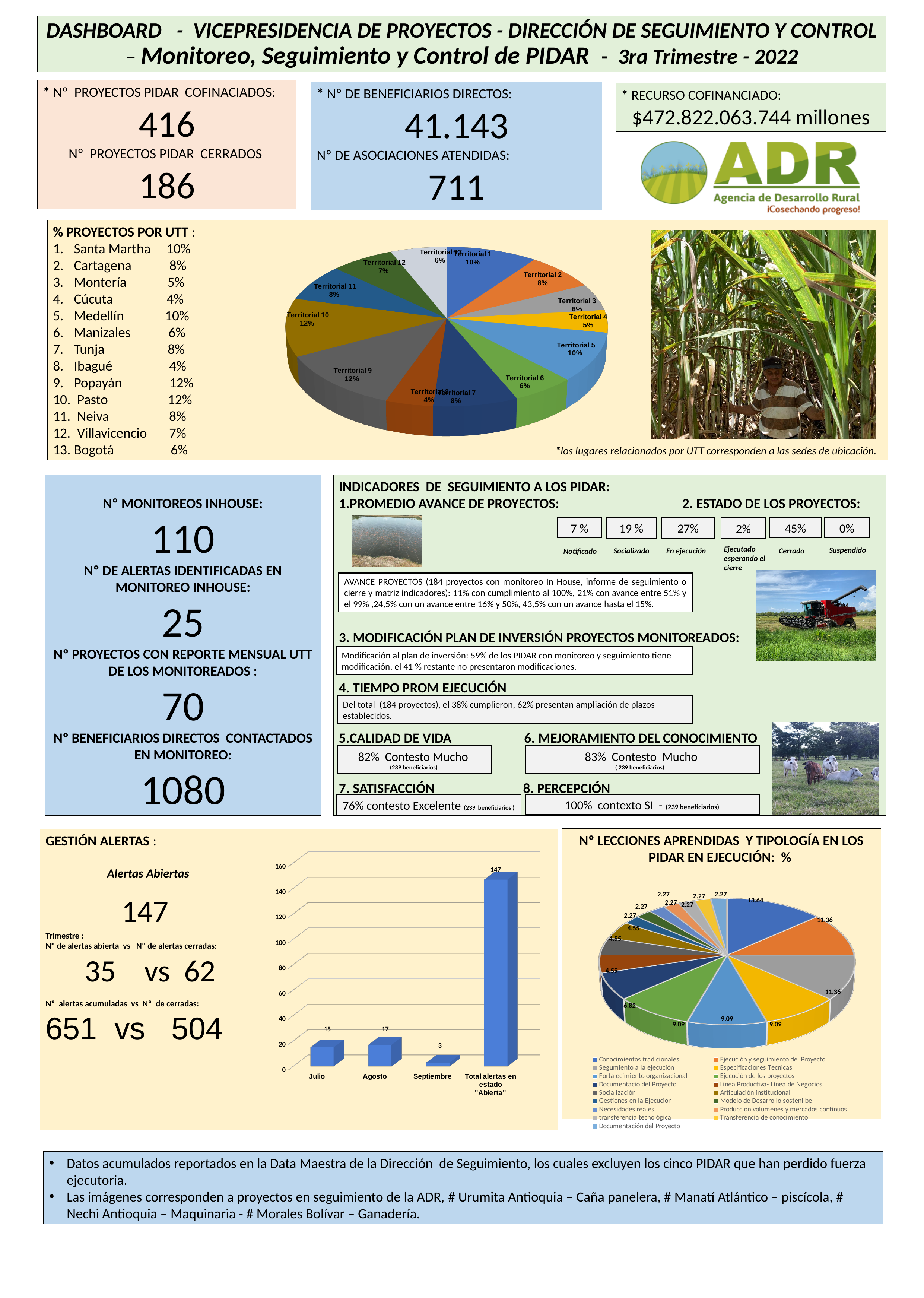
In the bar chart under GESTIÓN ALERTAS, what is the value for Agosto? 17 In the bar chart under GESTIÓN ALERTAS, which category has the highest value? Total alertas en estado "Abierta" In the bar chart under GESTIÓN ALERTAS, how many categories are shown on the x axis? 4 In the bar chart under GESTIÓN ALERTAS, what is the value for Septiembre? 3 In the bar chart under GESTIÓN ALERTAS, what is the value for Julio? 15 In the pie chart next to % PROYECTOS POR UTT, how many slices are there? 13 In the pie chart next to % PROYECTOS POR UTT, what percentage is shown for Territorial 8? 4% What kind of chart is shown under GESTIÓN ALERTAS? Bar chart In the pie chart next to % PROYECTOS POR UTT, what percentage is shown for Territorial 10? 12% In the bar chart under GESTIÓN ALERTAS, which category has the lowest value? Septiembre In the bar chart under GESTIÓN ALERTAS, what is the difference between the values for Agosto and Julio? 2 In the pie chart titled N° LECCIONES APRENDIDAS Y TIPOLOGÍA EN LOS PIDAR EN EJECUCIÓN, what is the largest slice value shown? 13.64